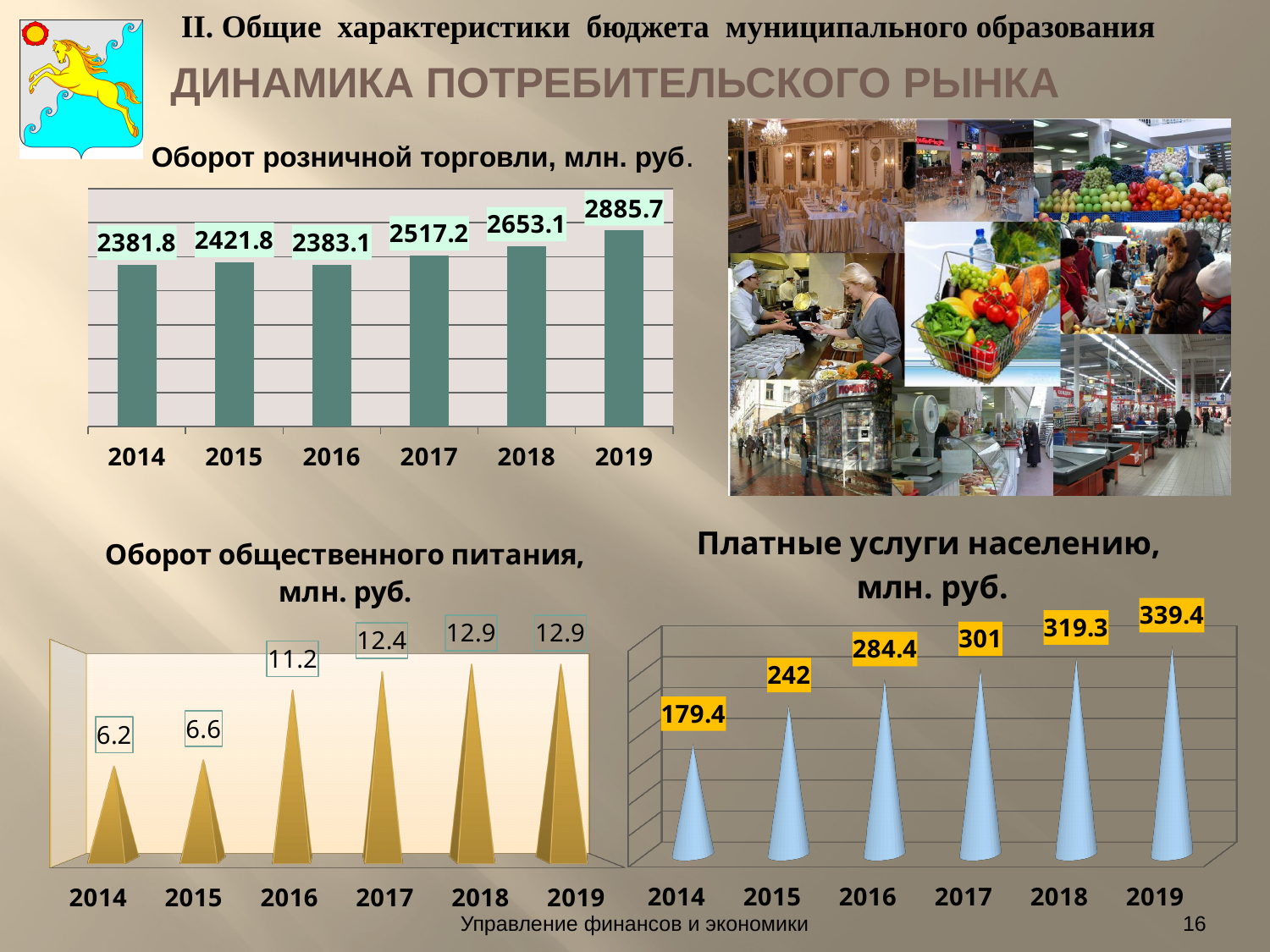
In the chart 'Платные услуги населению, млн. руб.', what is the value for 2017? 301 In the chart 'Оборот общественного питания, млн. руб.', what is the difference between the 2017 and 2014 values? 6.2 In the chart 'Оборот общественного питания, млн. руб.', do the values generally rise or fall from 2014 to 2019? rise In the chart 'Оборот розничной торговли, млн. руб.', which is larger, the value for 2015 or the value for 2016? 2015 In the chart 'Оборот общественного питания, млн. руб.', how many years are shown on the x axis? 6 In the chart 'Оборот розничной торговли, млн. руб.', what is the value for 2019? 2885.7 In the chart 'Платные услуги населению, млн. руб.', what is the difference between the 2015 and 2014 values? 62.6 In the chart 'Оборот розничной торговли, млн. руб.', what is the difference between the 2019 and 2018 values? 232.6 In the chart 'Оборот розничной торговли, млн. руб.', which year has the lowest value? 2014 In the chart 'Платные услуги населению, млн. руб.', which year has the highest value? 2019 In the chart 'Оборот общественного питания, млн. руб.', what is the value for 2016? 11.2 How many charts are shown on the slide? 3